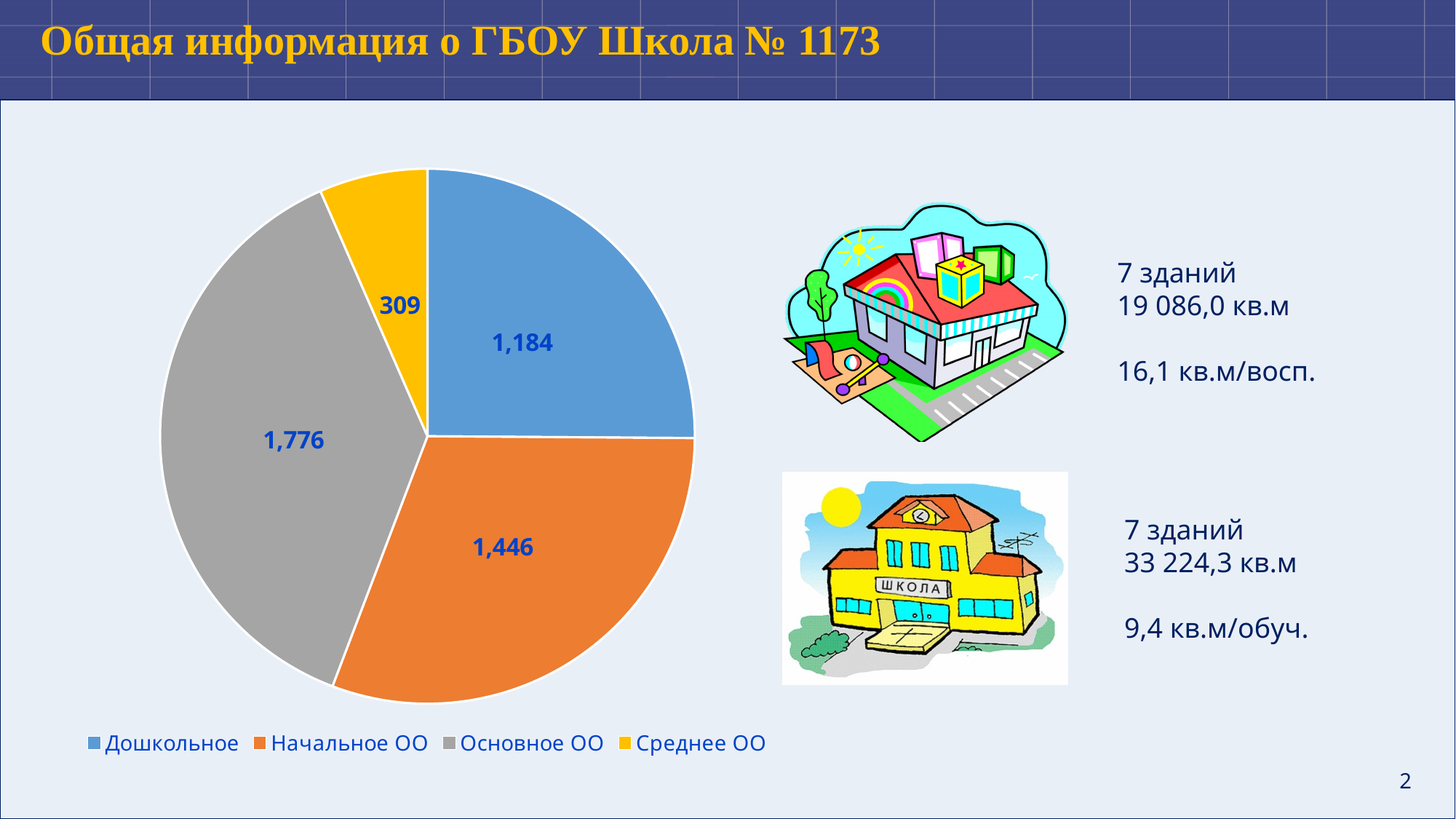
How many slices does the pie chart have? 4 What is the value for Основное ОО in the pie chart? 1,776 Which category has the smallest slice in the pie chart? Среднее ОО What is the difference between the values for Основное ОО and Начальное ОО? 330 Which category has the largest slice in the pie chart? Основное ОО What is the value for Среднее ОО in the pie chart? 309 What is the value for Начальное ОО in the pie chart? 1,446 Which is larger, the value for Начальное ОО or the value for Дошкольное? Начальное ОО Which colour represents Среднее ОО in the pie chart? yellow What is the value for Дошкольное in the pie chart? 1,184 What kind of chart is shown on the slide? pie chart What is the total of all slices in the pie chart? 4,715